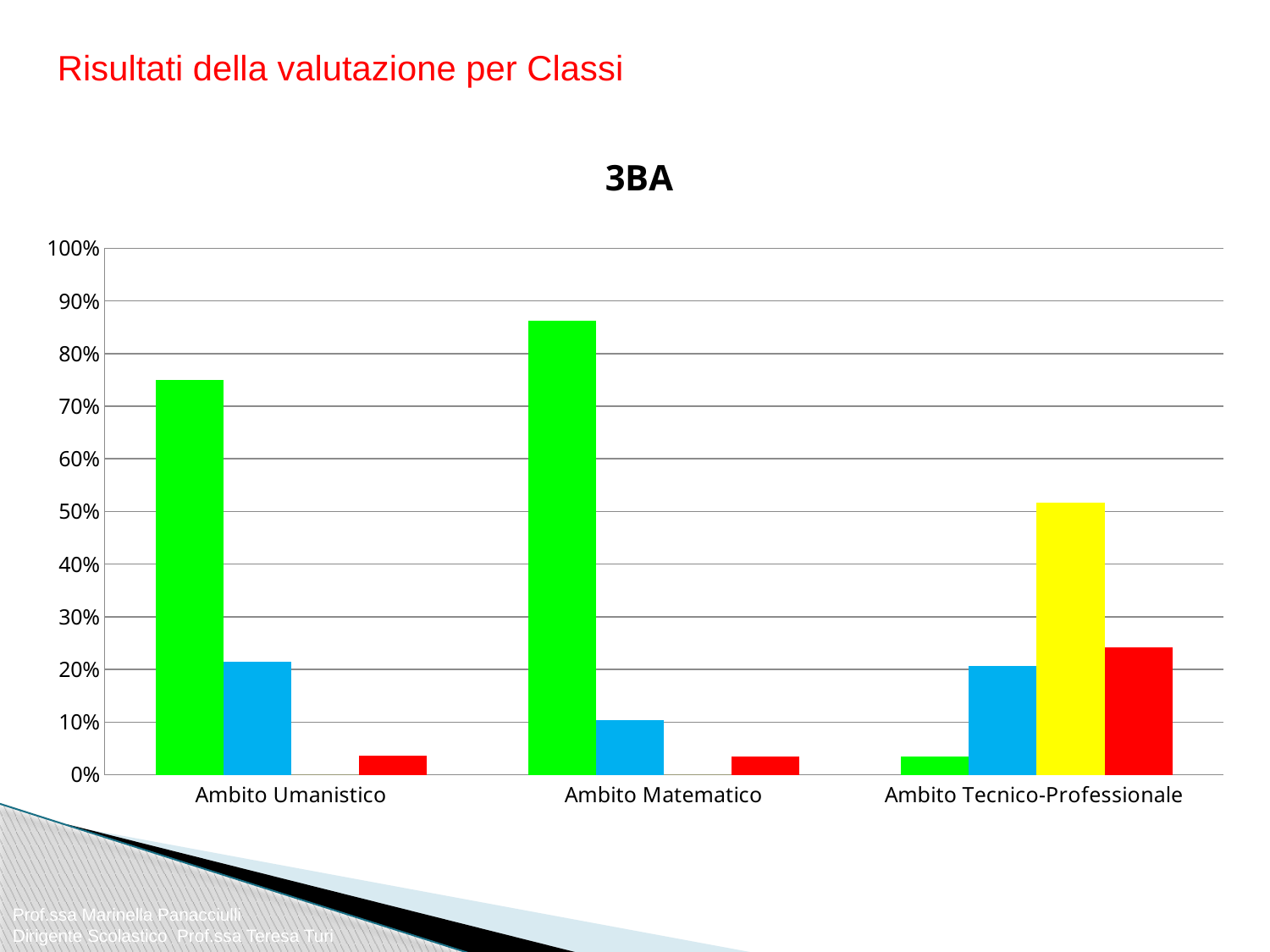
What kind of chart is shown on the slide? bar chart In which category is the green bar the highest? Ambito Matematico In which category is the green bar the lowest? Ambito Tecnico-Professionale Which is larger for Ambito Tecnico-Professionale, the yellow bar or the red bar? the yellow bar Which is larger for Ambito Umanistico, the green bar or the blue bar? the green bar Is the green bar for Ambito Umanistico greater or less than 70%? greater What is the title of the chart? 3BA Is the yellow bar for Ambito Tecnico-Professionale greater or less than 50%? greater Is the red bar for Ambito Tecnico-Professionale greater or less than 30%? less How many categories are shown on the x axis of the chart? 3